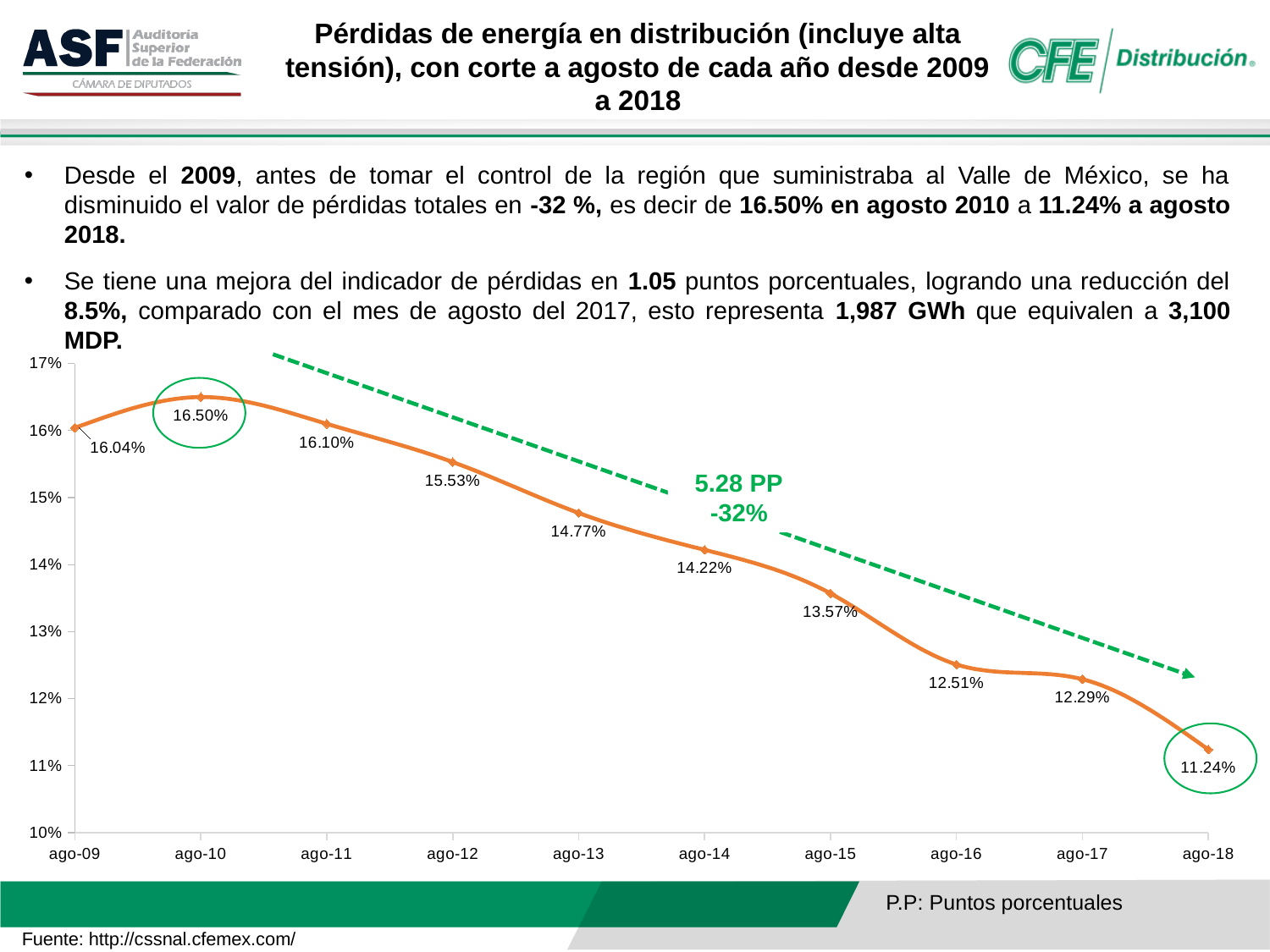
Which point on the x axis has the lowest value? ago-18 Is the value for ago-15 greater or less than 14%? less What kind of chart is shown on the slide? line chart Do the values rise or fall from ago-10 to ago-18? fall What is the value for ago-10? 16.50% Which point on the x axis has the highest value? ago-10 What is the value for ago-18? 11.24% How many data points are plotted on the chart? 10 What is the value for ago-14? 14.22% What is the value for ago-16? 12.51% Which is larger, the value for ago-09 or the value for ago-11? ago-11 What is the difference between the values for ago-10 and ago-18? 5.26%